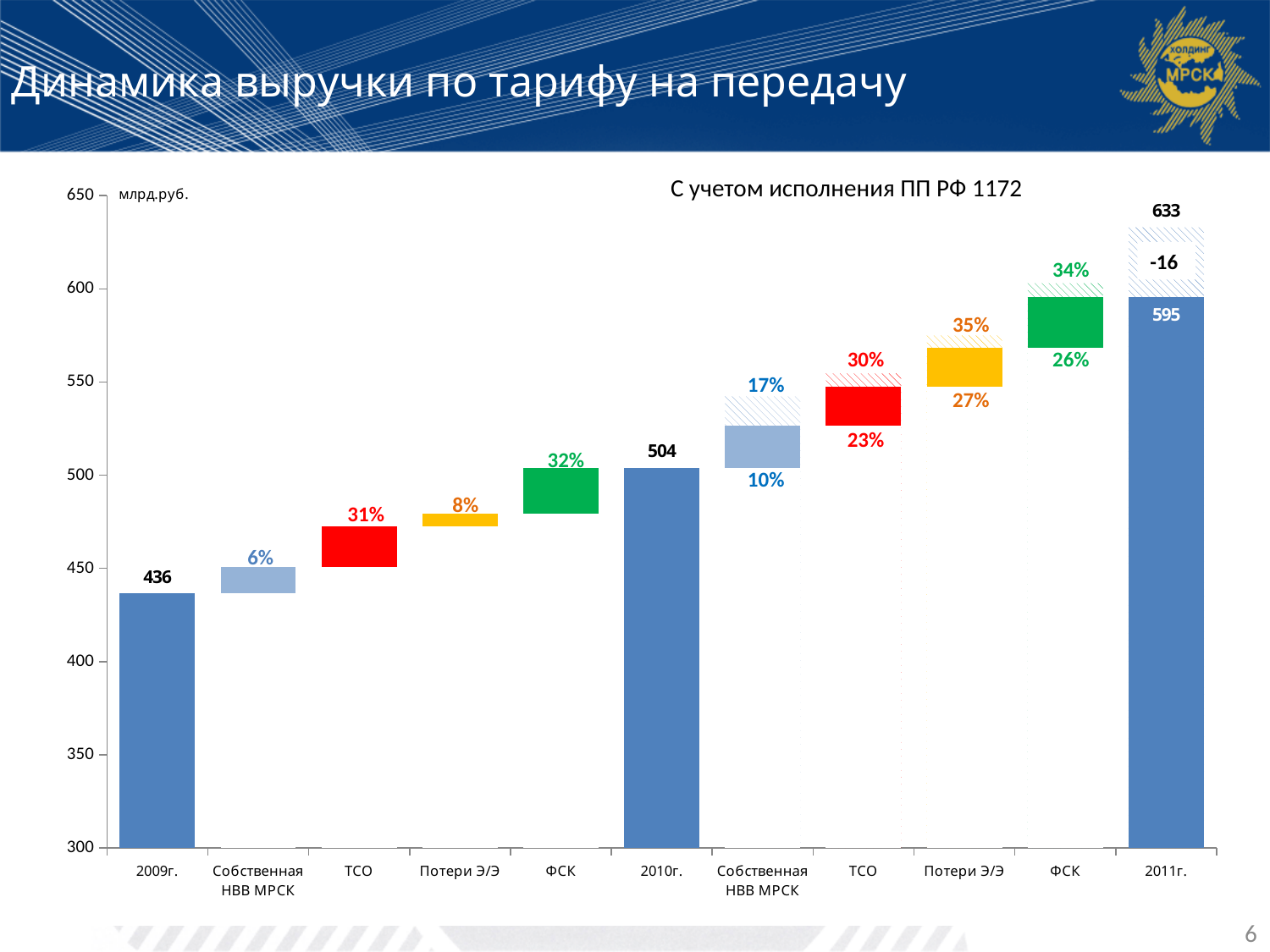
What is the value for 2009г.? 436 What is the value for 2010г.? 504 What percentage label is shown below the Потери Э/Э step between 2010г. and 2011г.? 27% What percentage label is shown above the ТСО step between 2009г. and 2010г.? 31% What is the value shown at the top of the 2011г. bar, with the hatched section included (С учетом исполнения ПП РФ 1172)? 633 What is the difference between the 2010г. and 2009г. values? 68 What is the value for 2011г. (solid bar)? 595 Which of the year bars is the highest: 2009г., 2010г. or 2011г.? 2011г. What is the difference between the 2011г. solid bar value (595) and the 2010г. value? 91 How many categories are shown on the x axis? 11 What unit is shown on the chart's value axis? млрд.руб. Which of the year bars is the lowest: 2009г., 2010г. or 2011г.? 2009г.